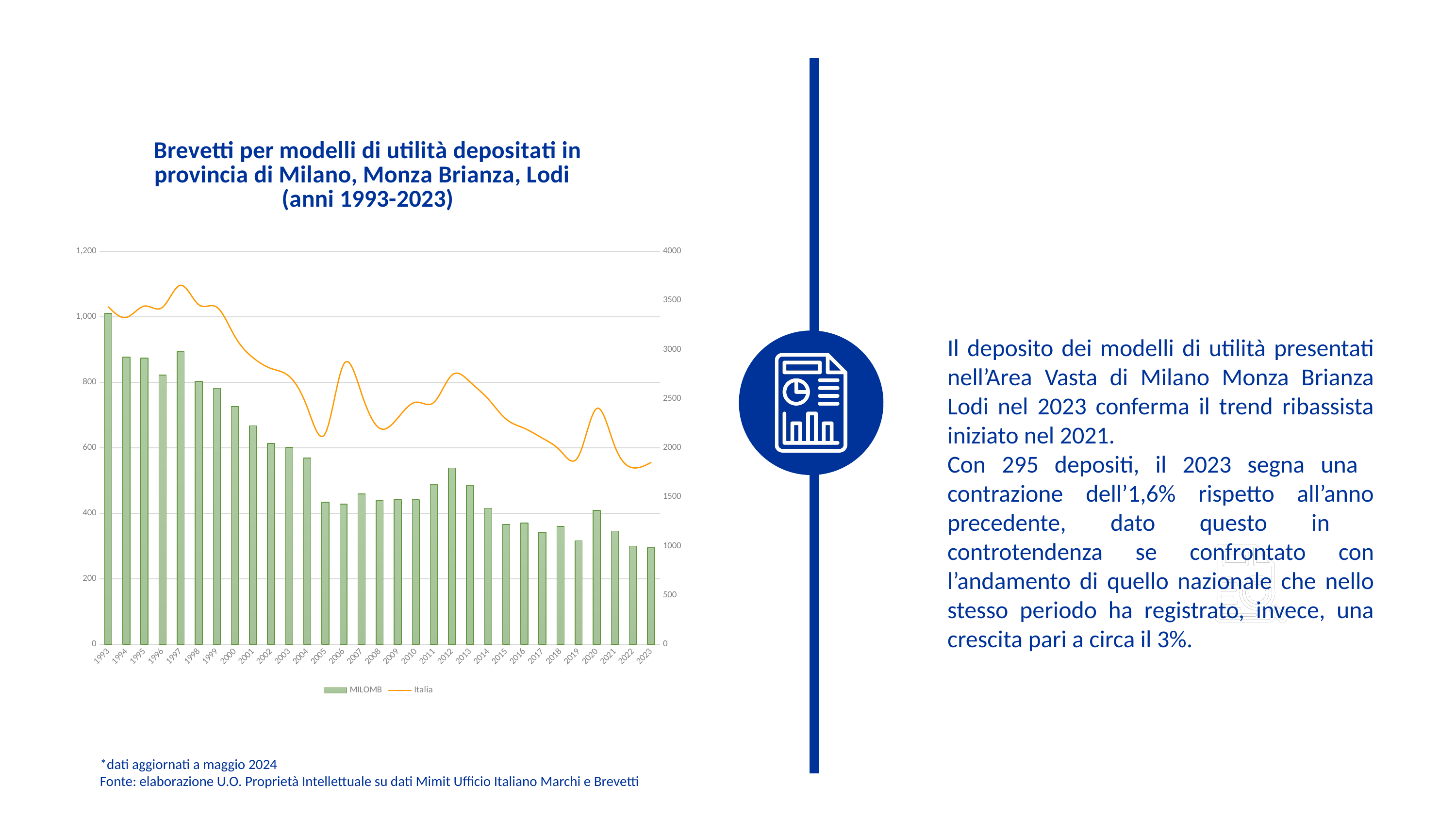
Which year has the larger MILOMB bar, 1997 or 1998? 1997 Is the MILOMB value for 2012 greater or less than 400? greater Is the Italia value for 2019 greater or less than 2000? less Is the MILOMB value for 2023 greater or less than 400? less In which year is the MILOMB bar highest? 1993 How many series does the chart's legend list? 2 Which series is drawn as bars and which as a line? MILOMB is bars, Italia is a line What kind of chart is shown on the slide? A combined bar and line chart How many years are plotted along the x axis of the chart? 31 Overall, do the MILOMB bars rise or fall from 1993 to 2023? fall